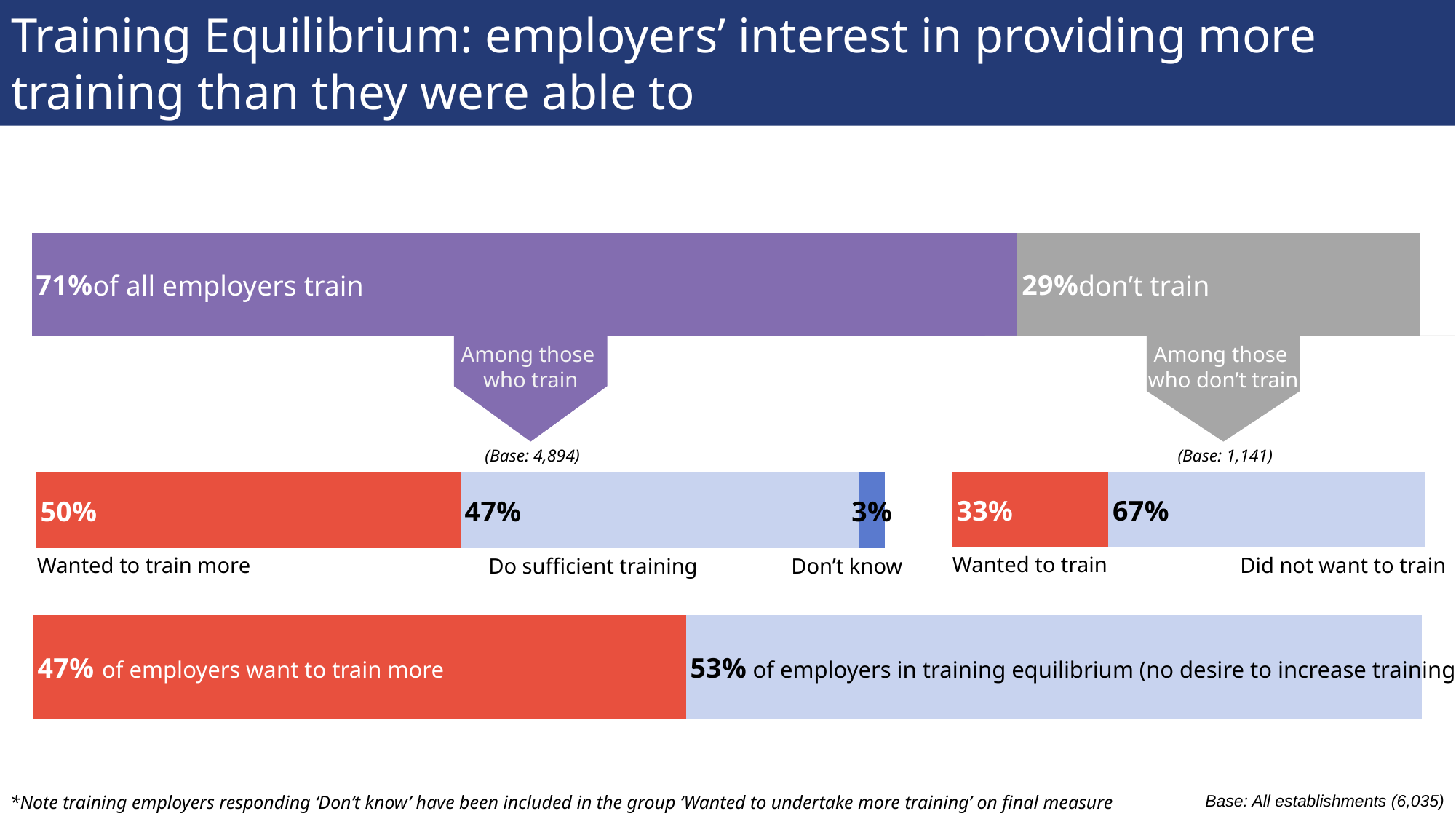
In the 'Among those who don't train' bar, which segment is largest? Did not want to train In the bottom bar, which is larger: employers who want to train more or employers in training equilibrium? Employers in training equilibrium In the 'Among those who train' bar, what percentage wanted to train more? 50% In the 'Among those who train' bar, what percentage do sufficient training? 47% In the 'Among those who train' bar, which segment is smallest? Don't know In the bottom bar, what percentage of employers want to train more? 47% In the 'Among those who don't train' bar, what percentage wanted to train? 33% In the 'Among those who don't train' bar, what is the difference between 'Did not want to train' and 'Wanted to train'? 34% How many segments does the 'Among those who train' bar have? 3 In the top bar, what percentage of employers don't train? 29% In the top bar, what percentage of all employers train? 71% In the 'Among those who train' bar, what percentage answered 'Don't know'? 3%